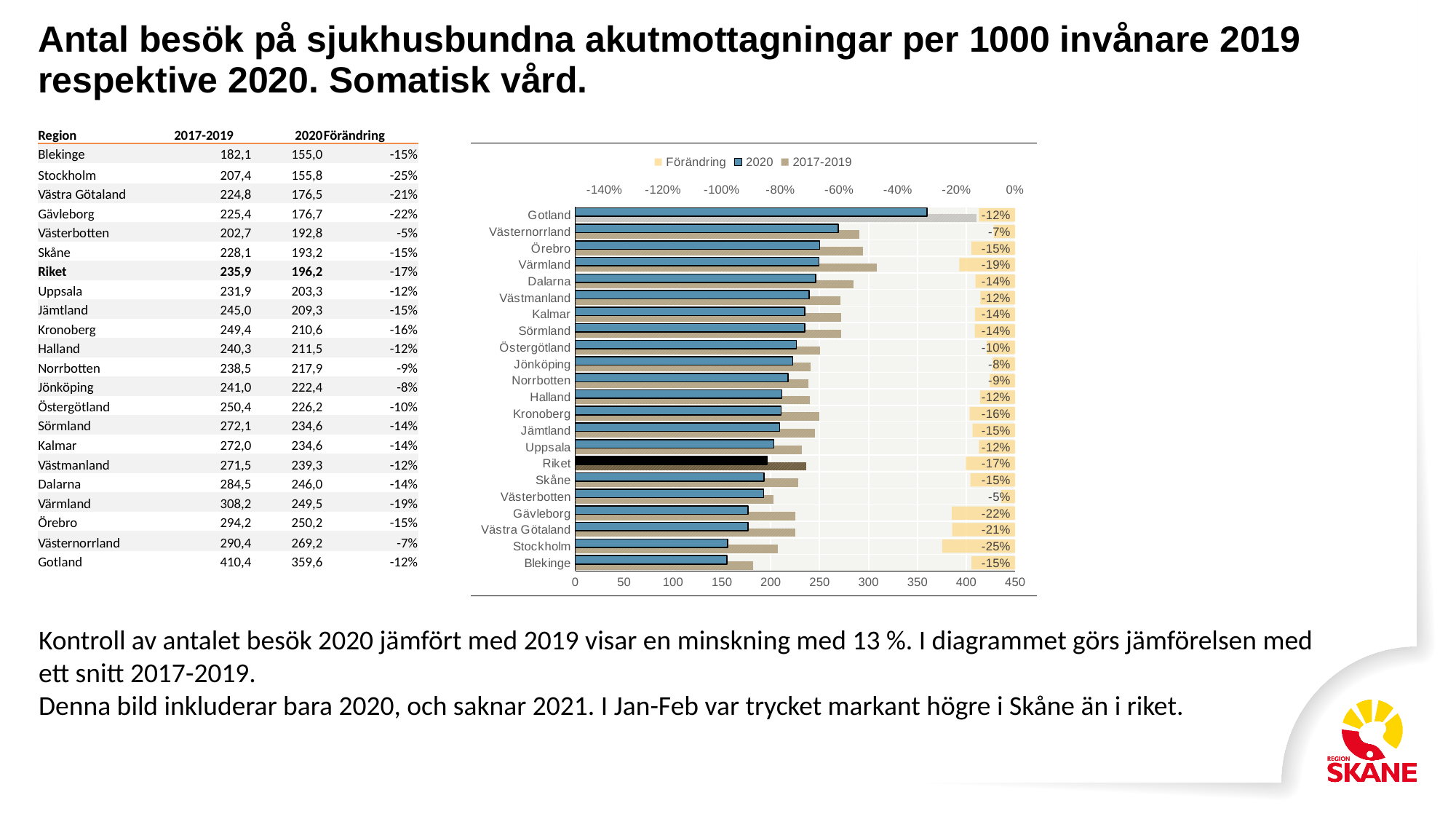
Is the 2020 value for Blekinge greater or less than 200? less How many series does the legend list? 3 Which region has the most negative Förändring value? Stockholm What is the Förändring value shown for Västerbotten? -5% Is the 2020 value for Gotland greater or less than 300? greater How many regions (categories) are plotted on the chart? 22 What is the Förändring value shown for Stockholm? -25% What is the difference between the Förändring values for Stockholm and Västerbotten? 20 percentage points Which region has the longer 2020 bar, Gotland or Stockholm? Gotland What kind of chart is shown? Bar chart Which region has the smallest decrease (least negative Förändring value)? Västerbotten What is the Förändring value shown for Riket? -17%